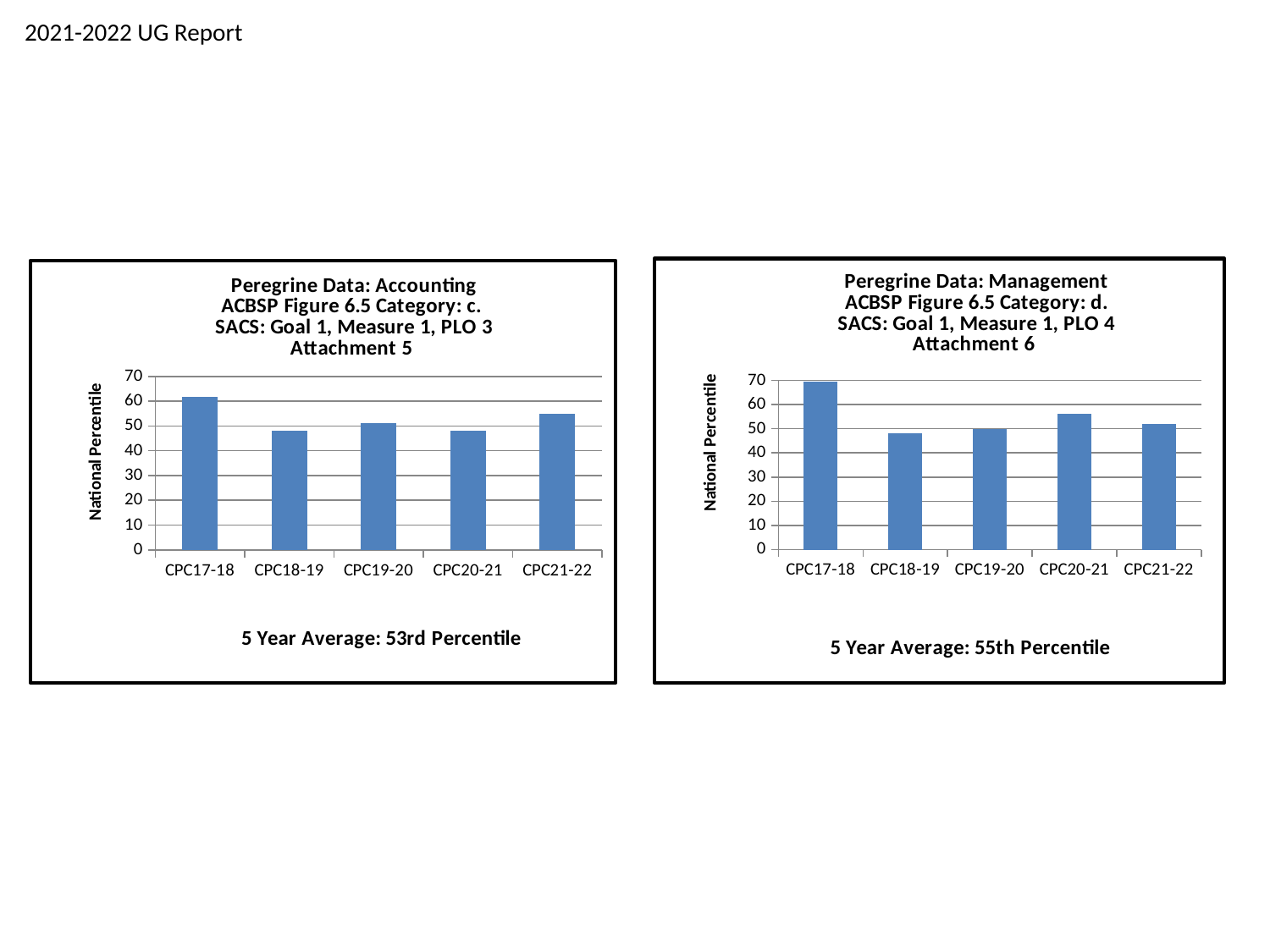
In the Peregrine Data: Management chart, is the value for CPC17-18 greater or less than 60? greater What kind of chart is the Peregrine Data: Accounting chart? bar chart What is the y-axis label on the Peregrine Data: Management chart? National Percentile In the Peregrine Data: Accounting chart, which category has the highest value? CPC17-18 In the Peregrine Data: Management chart, which category has the lowest value? CPC18-19 In the Peregrine Data: Management chart, is the value for CPC20-21 greater or less than 50? greater In the Peregrine Data: Management chart, which category has the highest value? CPC17-18 How many categories are shown on the x axis of the Peregrine Data: Management chart? 5 What 5 year average is stated below the Peregrine Data: Accounting chart? 53rd Percentile In the Peregrine Data: Accounting chart, is the value for CPC17-18 greater or less than 60? greater In the Peregrine Data: Accounting chart, which is larger, the value for CPC21-22 or the value for CPC20-21? CPC21-22